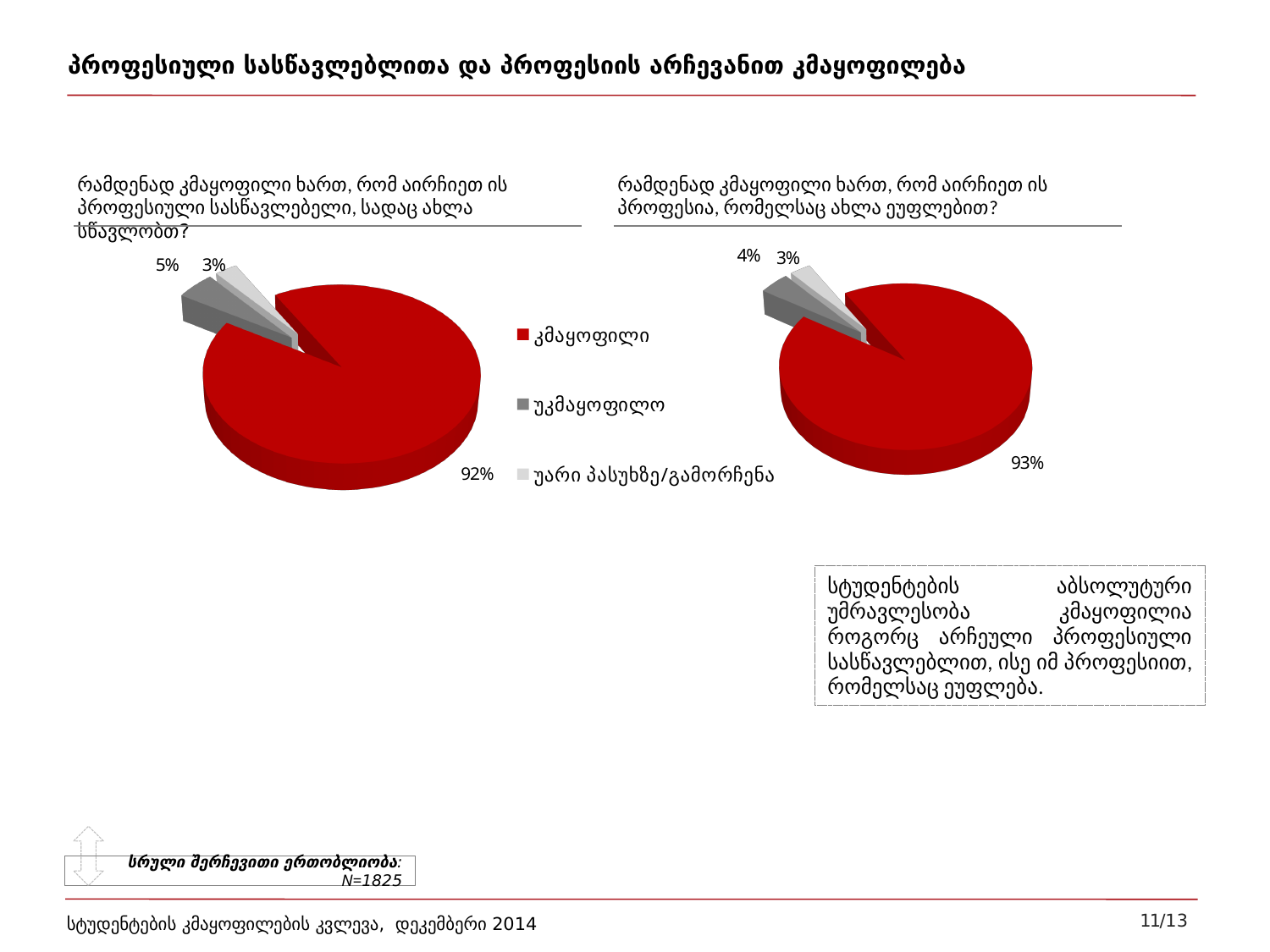
In the left pie chart, which category has the largest share? კმაყოფილი In the right pie chart, what percentage is shown for კმაყოფილი? 93% In the left pie chart, which category has the smallest share? უარი პასუხზე/გამორჩენა In the right pie chart, what percentage is shown for უარი პასუხზე/გამორჩენა? 3% In the left pie chart, what percentage is shown for უკმაყოფილო? 5% How many entries does the legend list? 3 What type of chart is used on the left side of the slide? Pie chart What is the difference between the კმაყოფილი share in the right pie chart and the კმაყოფილი share in the left pie chart? 1% In the left pie chart, what percentage is shown for კმაყოფილი? 92% In the right pie chart, what percentage is shown for უკმაყოფილო? 4% Which is larger: the უკმაყოფილო share in the left pie chart or in the right pie chart? Left pie chart How many slices does the left pie chart have? 3